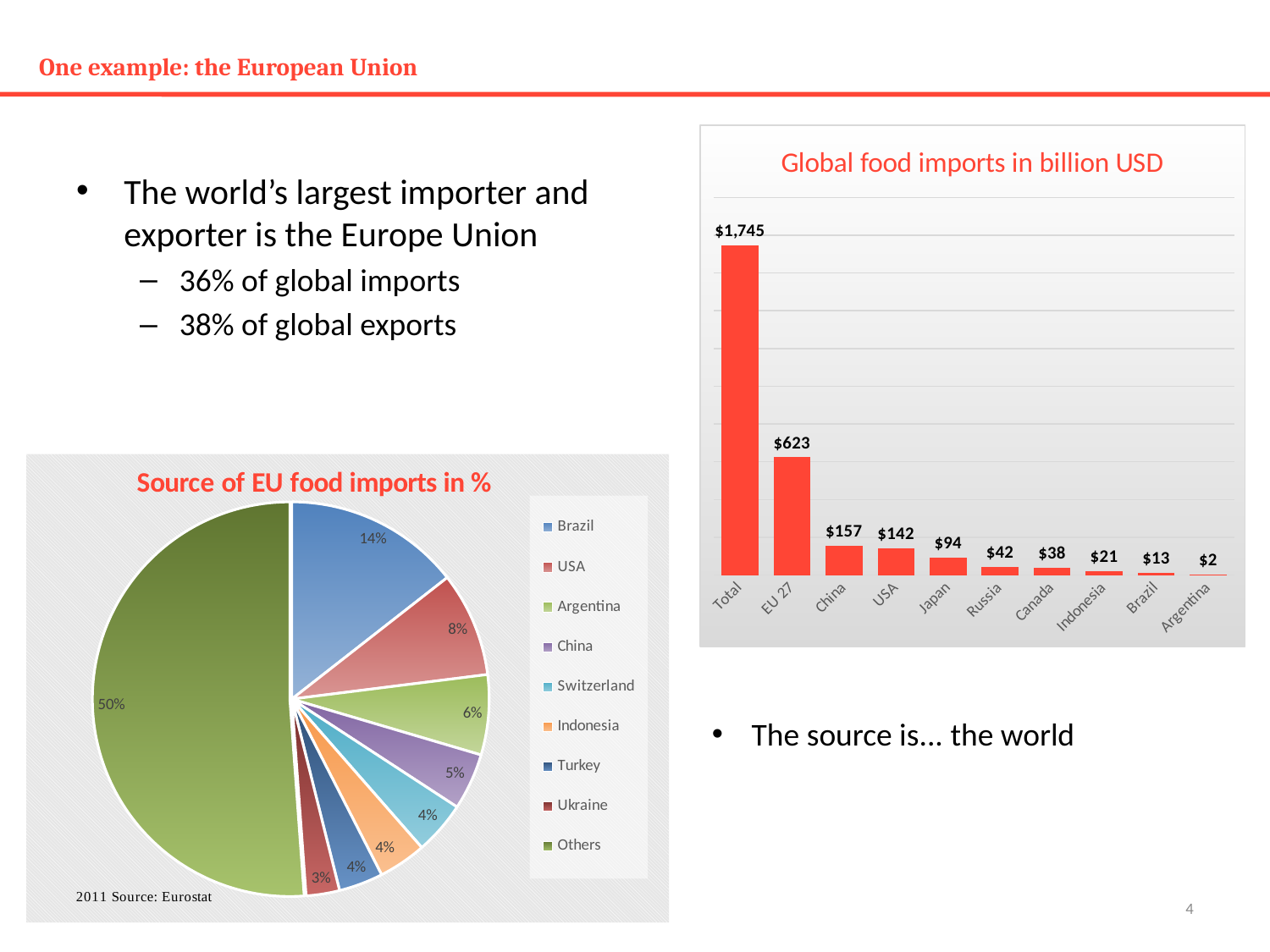
What kind of chart is 'Source of EU food imports in %'? Pie chart In the 'Source of EU food imports in %' chart, what share does Ukraine have? 3% In the 'Global food imports in billion USD' chart, what is the value for EU 27? $623 In the 'Global food imports in billion USD' chart, which category has the lowest value? Argentina In the 'Global food imports in billion USD' chart, what is the difference between the values for China and USA? $15 How many categories are shown in the 'Global food imports in billion USD' chart? 10 In the 'Global food imports in billion USD' chart, what is the value for China? $157 In the 'Source of EU food imports in %' chart, what share does Brazil have? 14% In the 'Global food imports in billion USD' chart, which is larger, the value for Japan or the value for Russia? Japan What kind of chart is 'Global food imports in billion USD'? Bar chart In the 'Source of EU food imports in %' chart, which slice is the largest? Others How many entries does the legend of the 'Source of EU food imports in %' chart list? 9